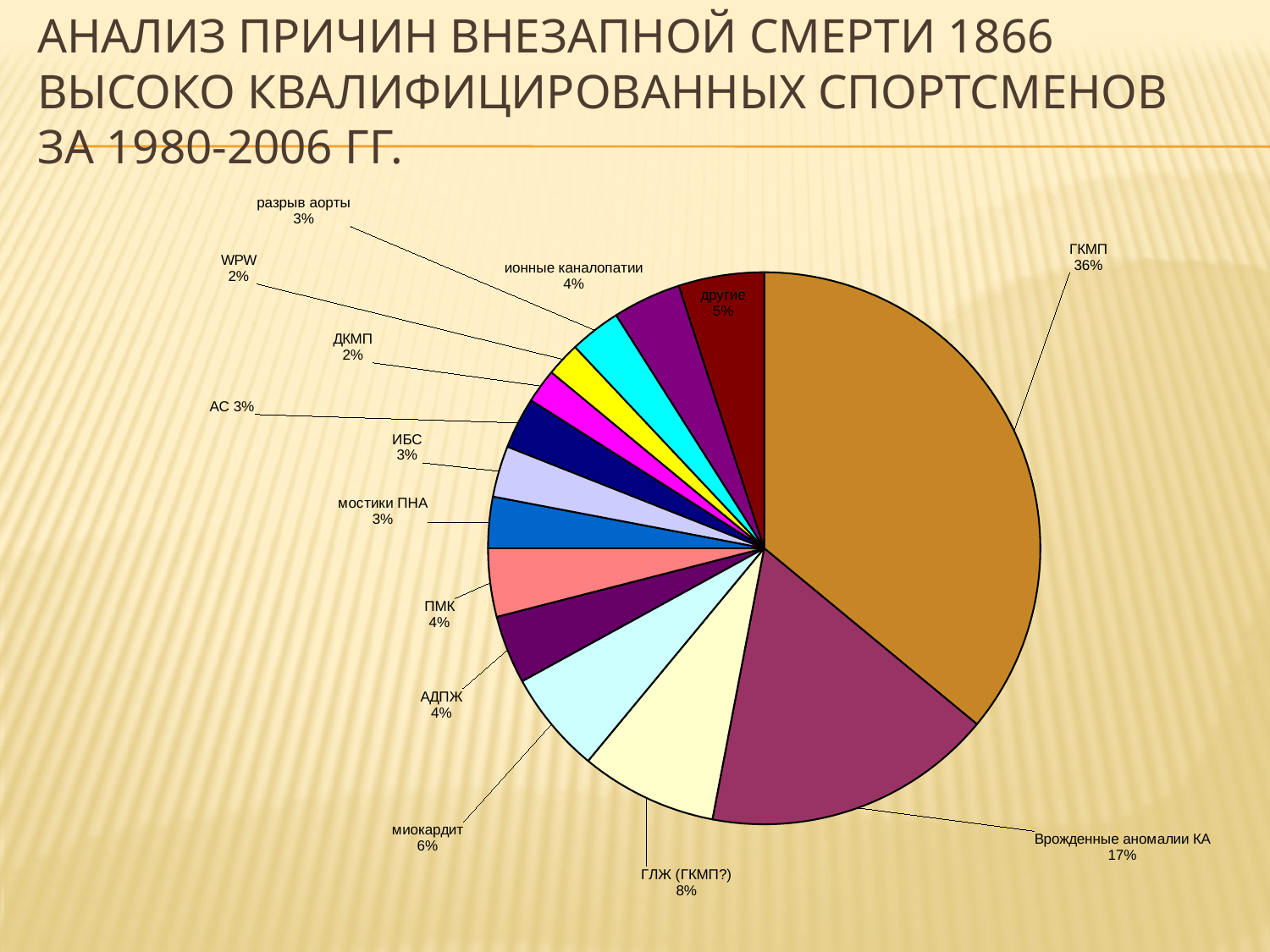
What share of the pie does ГКМП account for? 36% Which category has the largest slice of the pie? ГКМП What percentage is shown for Врожденные аномалии КА? 17% What percentage is shown for ГЛЖ (ГКМП?)? 8% What is the difference in percentage points between ГКМП and Врожденные аномалии КА? 19 What percentage is shown for миокардит? 6% How many slices does the pie chart have? 14 What percentage is shown for ионные каналопатии? 4% What is the combined share of ГКМП and ГЛЖ (ГКМП?)? 44% Which is larger, the slice for миокардит or the slice for ПМК? миокардит What kind of chart is shown on the slide? pie chart What percentage is shown for the slice labelled другие? 5%